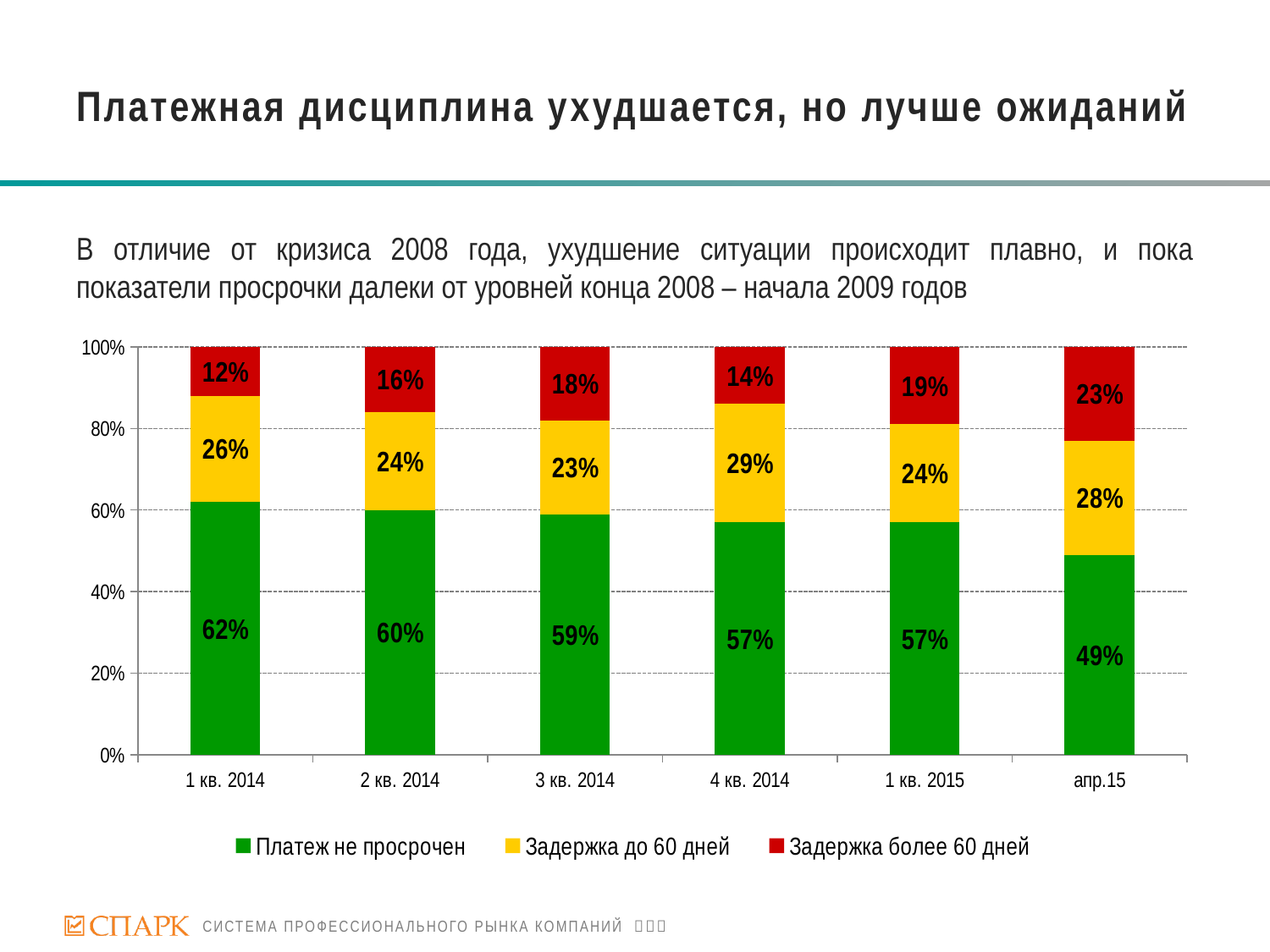
How many series does the legend list? 3 What is the value for 'Задержка более 60 дней' in апр.15? 23% What is the value for 'Задержка до 60 дней' in 4 кв. 2014? 29% Which is larger: 'Задержка до 60 дней' in 4 кв. 2014 or in 3 кв. 2014? 4 кв. 2014 How many categories are shown on the x axis? 6 What is the value for 'Платеж не просрочен' in 1 кв. 2014? 62% Does the 'Платеж не просрочен' series rise or fall from 1 кв. 2014 to апр.15? fall Which category has the lowest value for 'Платеж не просрочен'? апр.15 What kind of chart is shown on the slide? stacked bar chart What is the total of the stacked bar for 2 кв. 2014? 100% What is the difference between the 'Платеж не просрочен' values for 1 кв. 2014 and апр.15? 13% Which category has the highest value for 'Задержка более 60 дней'? апр.15